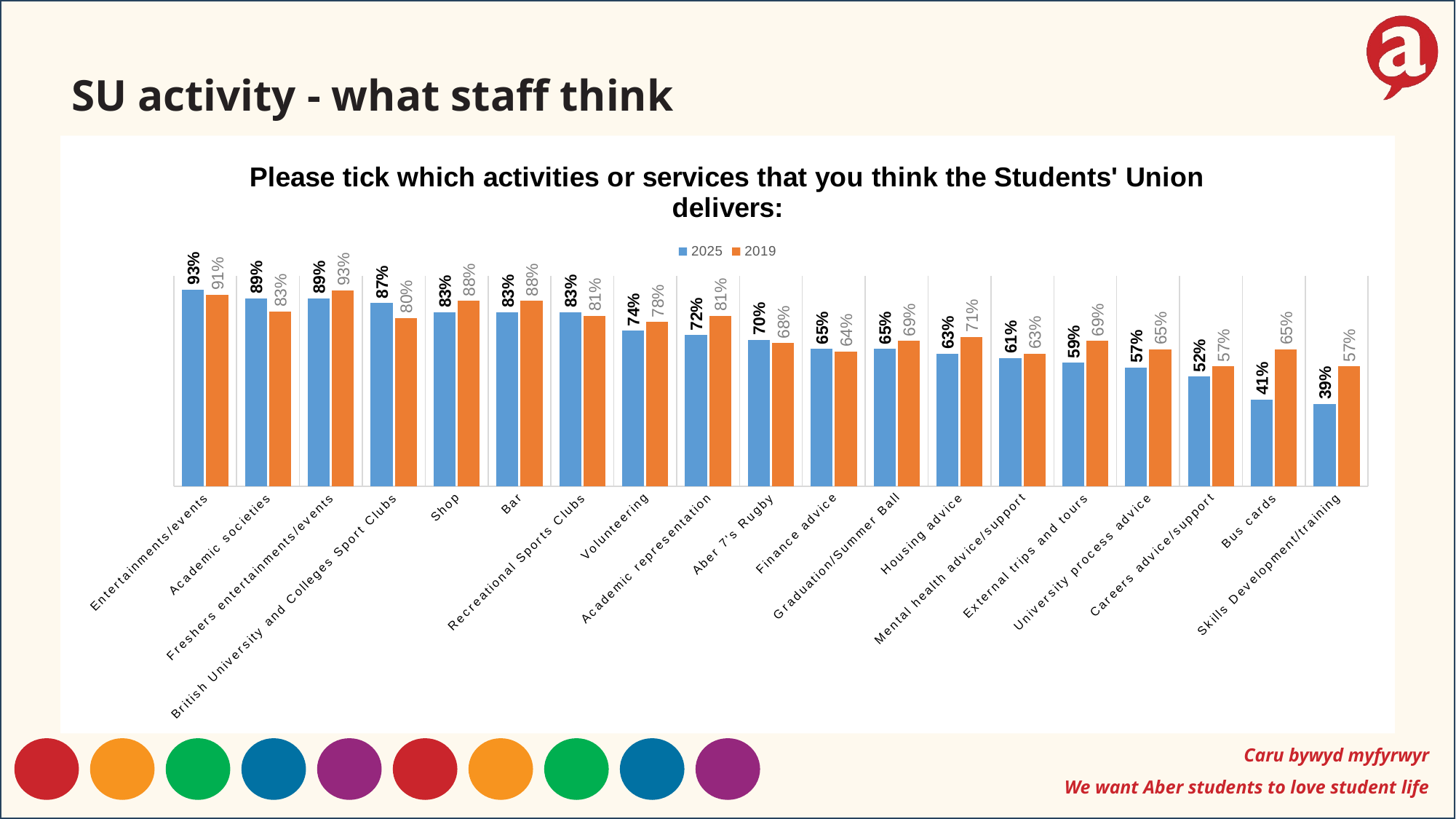
Which colour represents the 2019 series? Orange How many activities or services are shown on the x axis? 19 What percentage of staff in 2025 thought the Students' Union delivers Bus cards? 41% Which activity has the highest 2019 value? Freshers entertainments/events What type of chart is shown on the slide? Bar chart For Academic representation, which year has the higher value, 2025 or 2019? 2019 What is the difference between the 2019 and 2025 values for Bus cards? 24% How many series does the legend list? 2 What percentage is shown for Volunteering in the 2025 series? 74% What was the 2019 value for Housing advice? 71% Which activity has the lowest 2025 value? Skills Development/training Which activity has the highest 2025 value? Entertainments/events